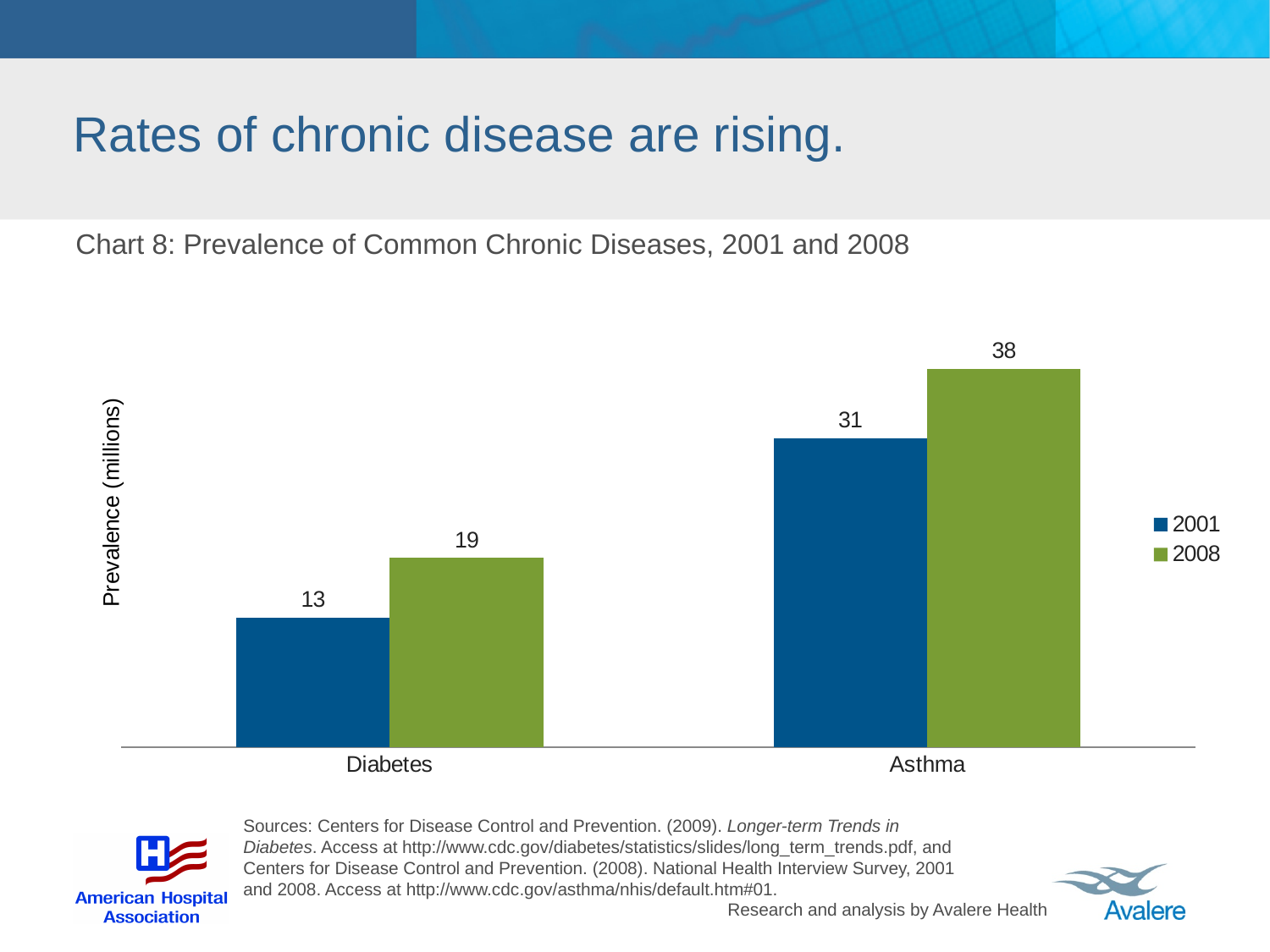
Which bar has the lowest value on the chart? Diabetes, 2001 What is the prevalence of diabetes in 2001? 13 Which is larger: the 2008 value for diabetes or the 2001 value for asthma? 2001 value for asthma What kind of chart is shown on the slide? Bar chart What is the prevalence of diabetes in 2008? 19 Which bar has the highest value on the chart? Asthma, 2008 What is the prevalence of asthma in 2001? 31 How many disease categories are shown on the x axis? 2 By how much did the prevalence of diabetes increase from 2001 to 2008? 6 What is the prevalence of asthma in 2008? 38 How many series does the legend list? 2 By how much did the prevalence of asthma increase from 2001 to 2008? 7